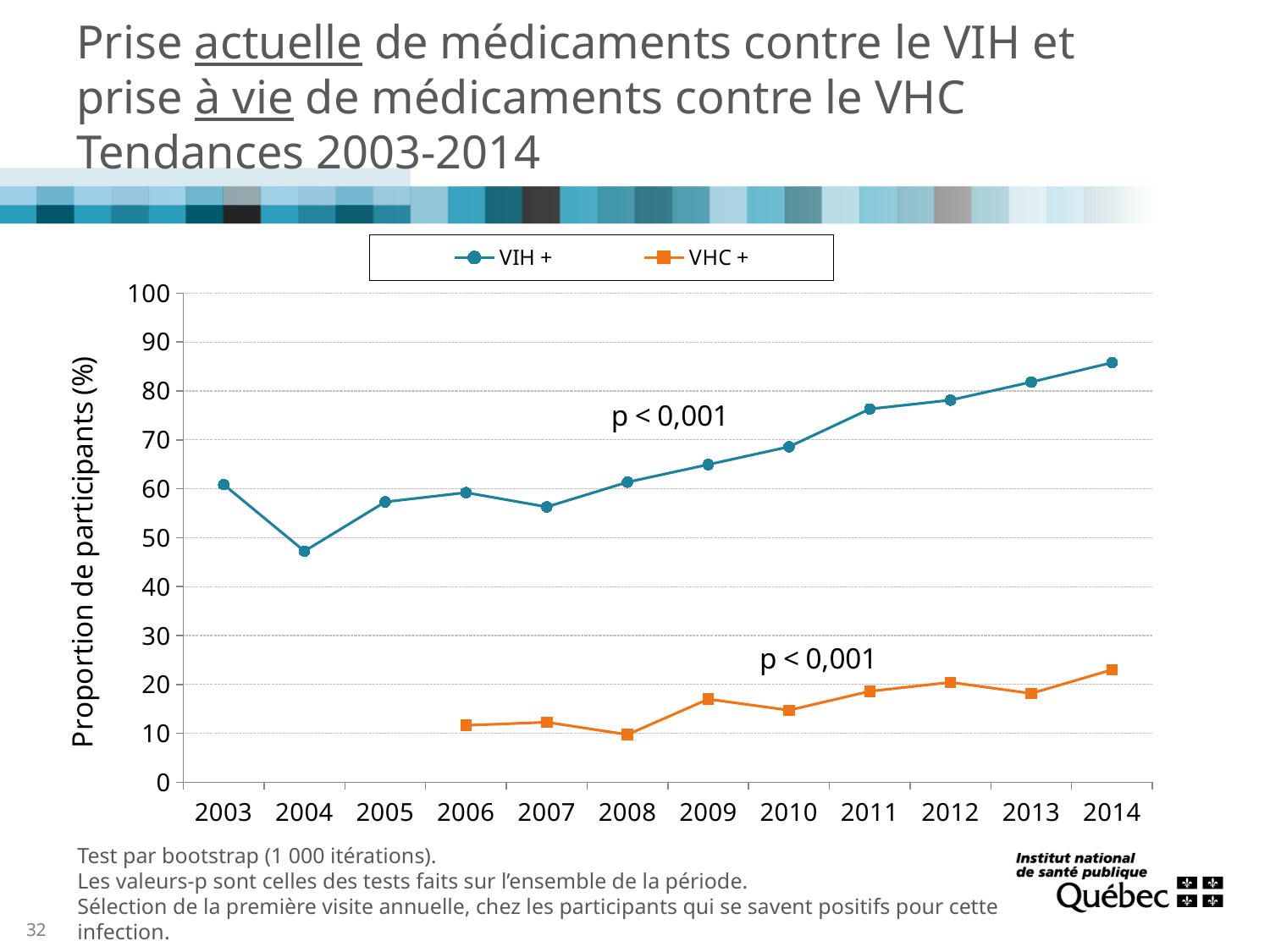
How many years are shown on the x axis? 12 Which is larger, the VIH + value in 2011 or the VIH + value in 2010? 2011 In which year is the VHC + series at its highest? 2014 Which two series are listed in the legend? VIH + and VHC + In which year is the VIH + series at its highest? 2014 What kind of chart is shown on the slide? Line chart How many series does the legend list? 2 Does the VIH + series rise or fall from 2008 to 2014? Rise Is the value for VIH + in 2014 greater or less than 80? greater Is the value for VIH + in 2004 greater or less than 50? less In which year is the VIH + series at its lowest? 2004 Is the value for VHC + in 2014 greater or less than 20? greater